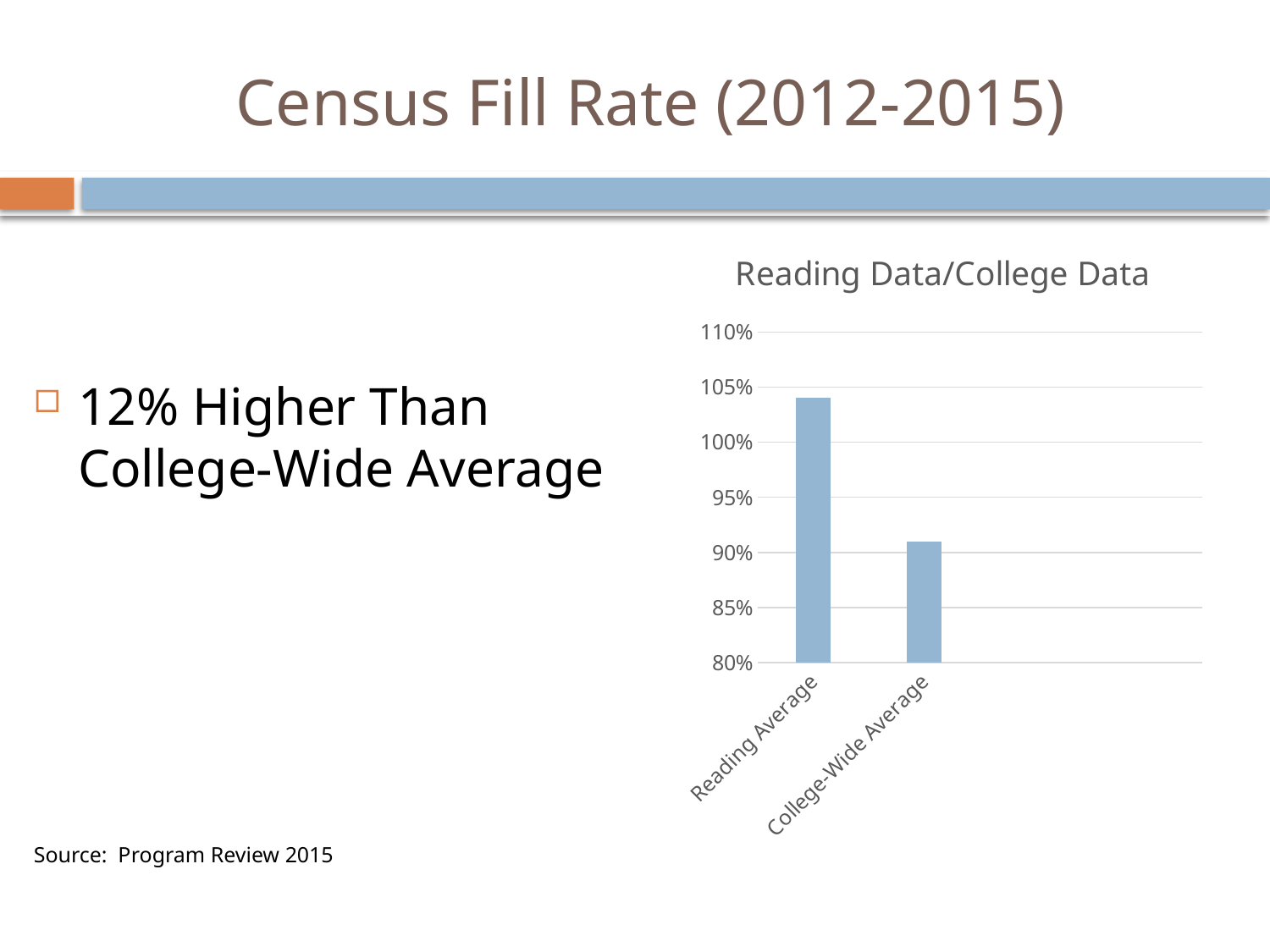
Which is larger, the value for Reading Average or the value for College-Wide Average? Reading Average Is the value for College-Wide Average greater or less than 95%? less Is the value for Reading Average greater or less than 100%? greater What is the lowest value shown on the vertical axis of the chart? 80% How many categories are plotted in the chart? 2 Which category has the lowest value in the chart? College-Wide Average Do the values rise or fall from left to right across the categories? fall What is the title of the chart? Reading Data/College Data What type of chart is shown on the slide? Bar chart Which category has the highest value in the chart? Reading Average Is the value for College-Wide Average greater or less than 85%? greater